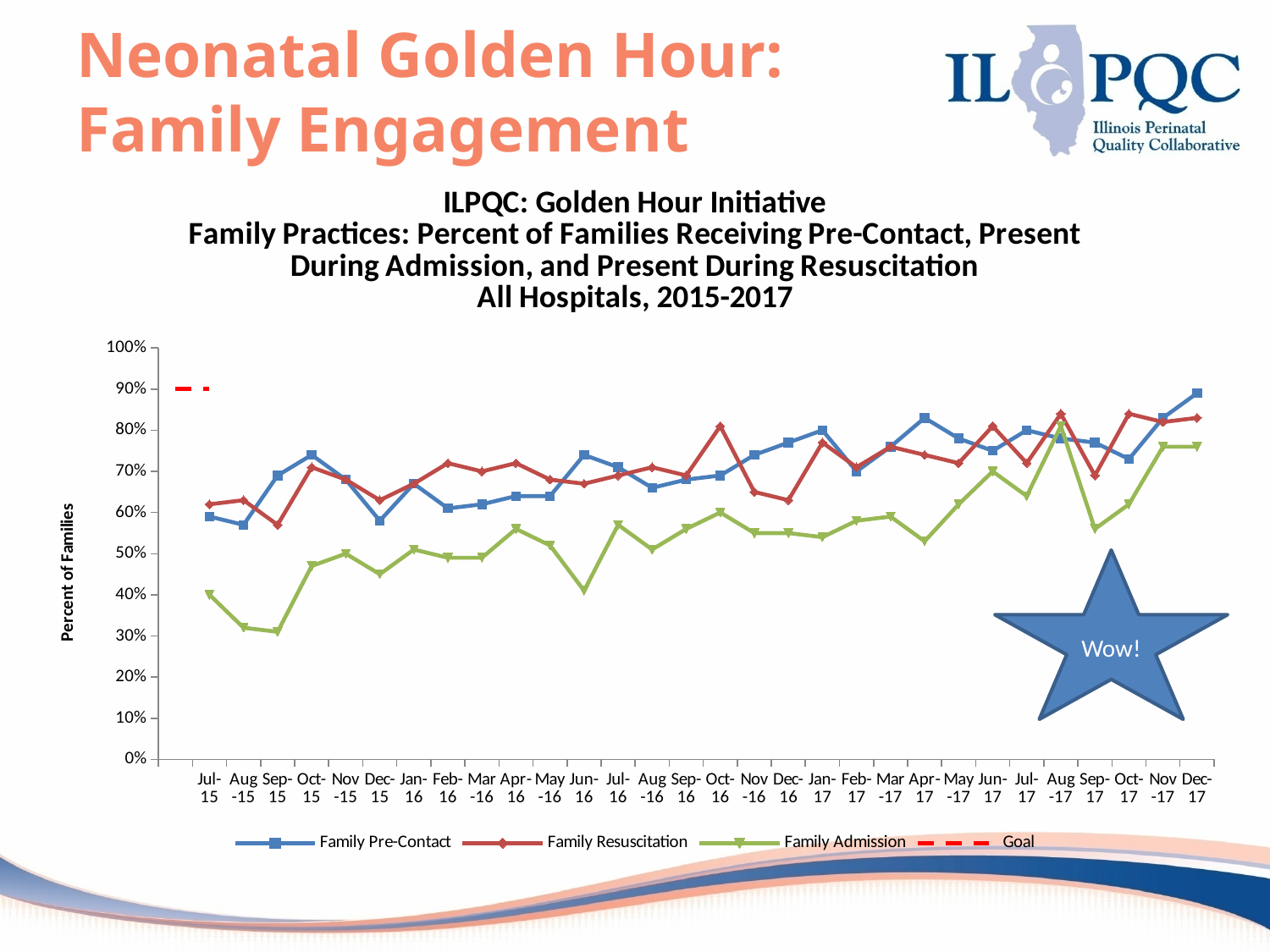
In which month does Family Pre-Contact reach its highest value? Dec-17 Is the value for Family Admission in Sep-15 greater or less than 40%? less Which series has the lowest value in Jul-15? Family Admission What kind of chart is shown on the slide? Line chart Is the value for Family Pre-Contact in Jul-15 greater or less than 70%? less In Sep-17, which is higher: Family Resuscitation or Family Admission? Family Resuscitation What value does the Goal line sit at? 90% How many months are plotted along the x axis? 30 Overall, does the Family Admission line rise or fall from Jul-15 to Dec-17? Rise Is the value for Family Admission in Aug-17 greater or less than 70%? greater How many series does the legend list? 4